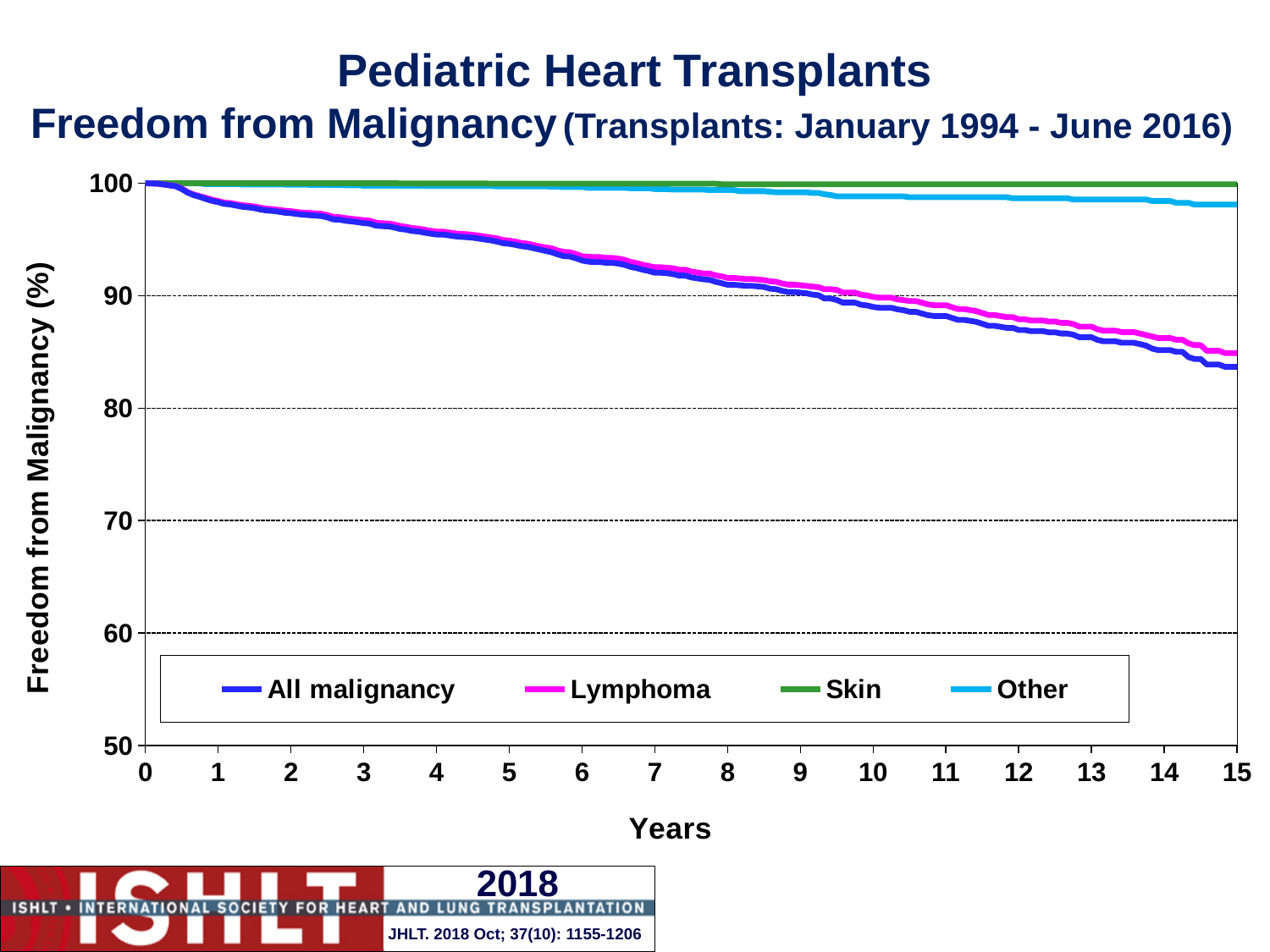
Is the value for All malignancy at 15 years greater or less than 80? greater How many series does the legend list? 4 Does the All malignancy line rise or fall as years increase? fall Is the value for All malignancy at 15 years greater or less than 90? less Which series are listed in the legend? All malignancy, Lymphoma, Skin, Other What kind of chart is shown on the slide? line chart Is the value for Lymphoma at 10 years greater or less than 80? greater What is the label of the x axis? Years Which series has the lowest value at 15 years? All malignancy At 10 years, which is larger: the value for Other or the value for Lymphoma? Other At 15 years, which is larger: the value for Skin or the value for All malignancy? Skin